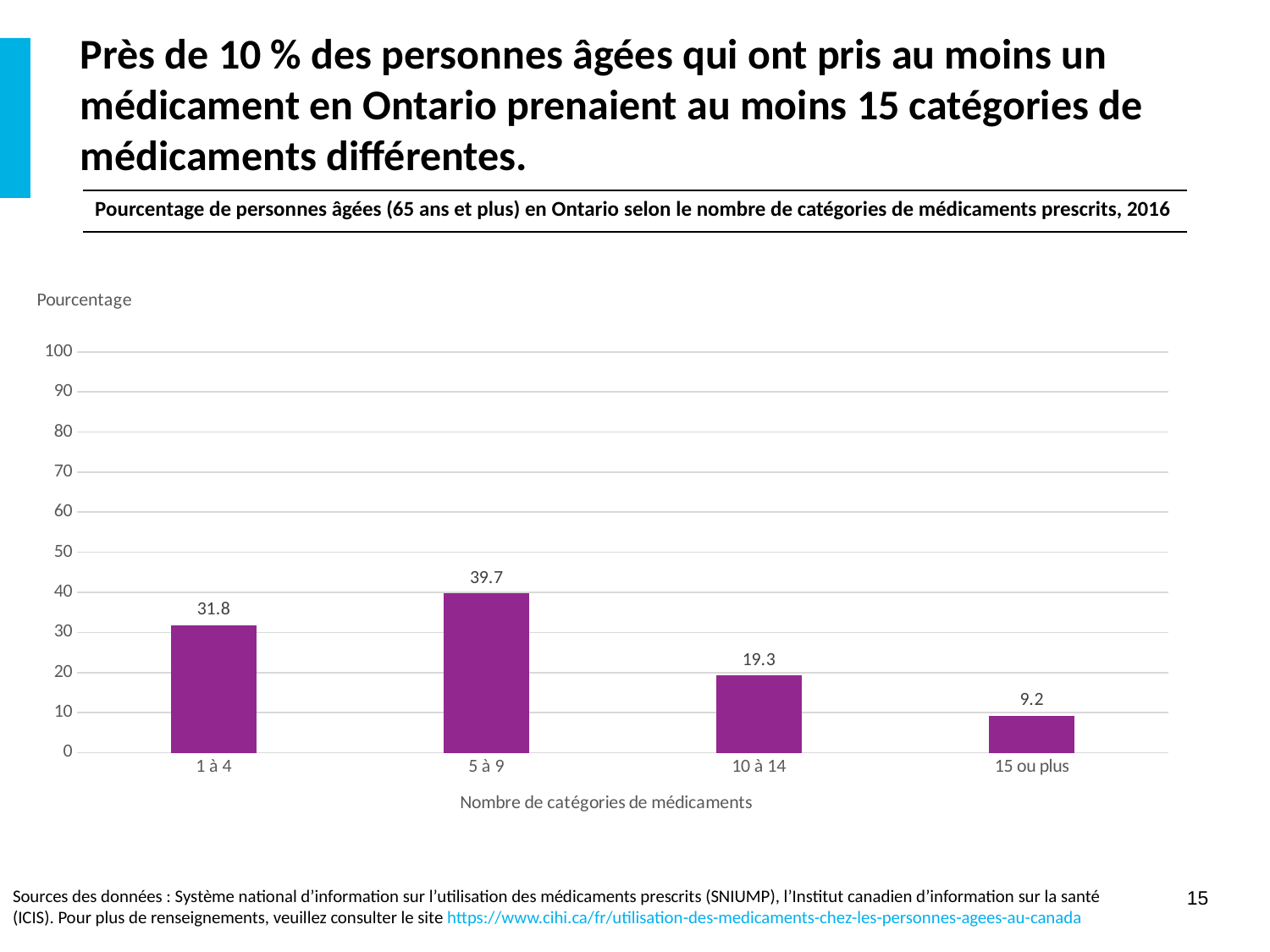
What kind of chart is shown on the slide? bar chart Which category has the lowest percentage? 15 ou plus What is the difference between the percentages for '10 à 14' and '15 ou plus'? 10.1 What is the difference between the percentages for '5 à 9' and '1 à 4'? 7.9 What is the percentage for the '5 à 9' category? 39.7 How many categories are shown on the x axis? 4 Which is larger, the percentage for '1 à 4' or for '10 à 14'? 1 à 4 What is the percentage for the '15 ou plus' category? 9.2 Is the value for '10 à 14' greater or less than 20? less What is the percentage for the '1 à 4' category? 31.8 What is the label of the x axis? Nombre de catégories de médicaments Which category has the highest percentage? 5 à 9